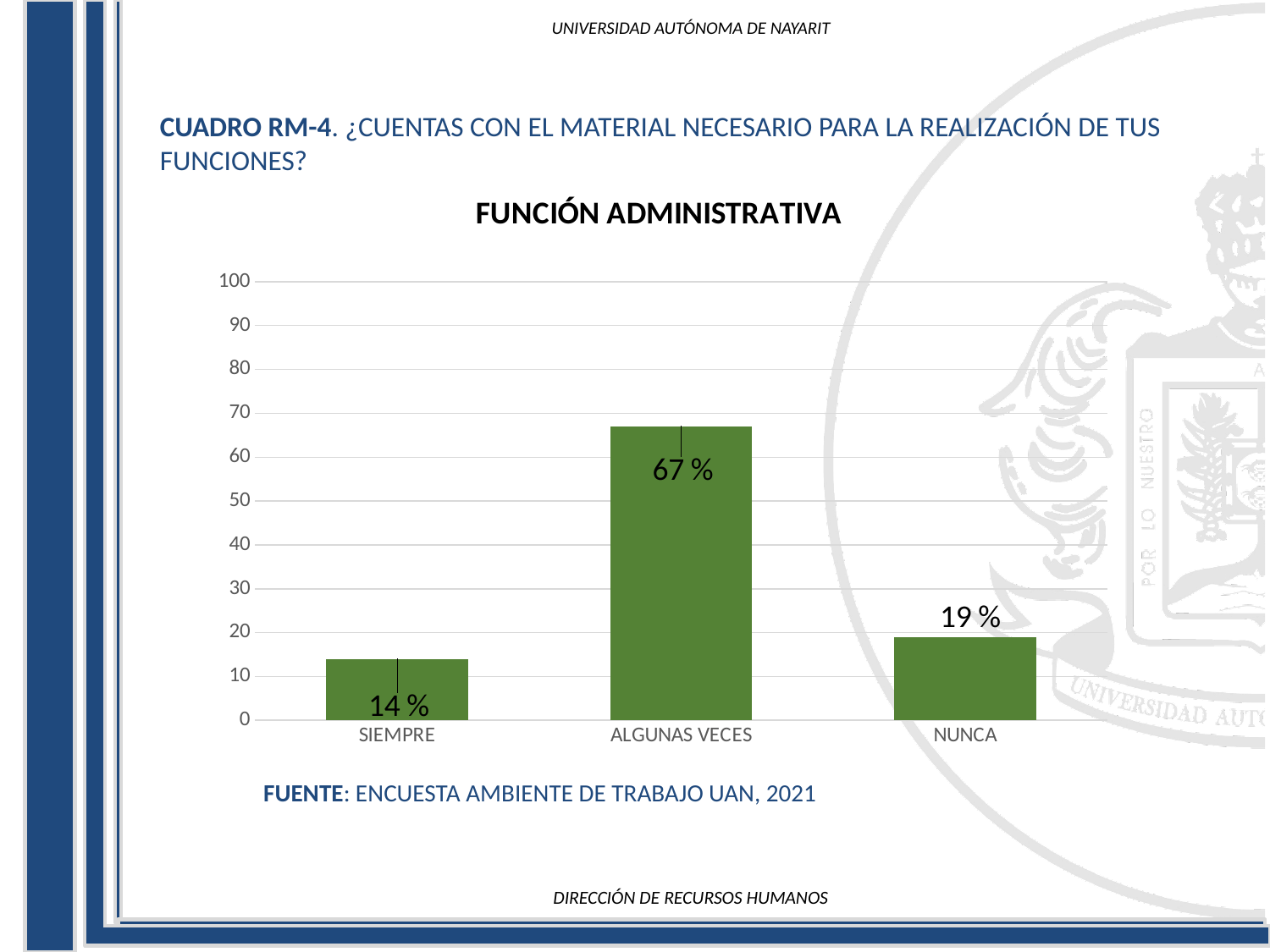
What is the value for NUNCA? 19 % Which is larger, the value for NUNCA or the value for SIEMPRE? NUNCA Which category has the highest value? ALGUNAS VECES What is the value for ALGUNAS VECES? 67 % What is the difference between the values for NUNCA and SIEMPRE? 5 % How many categories are shown on the x axis? 3 What is the value for SIEMPRE? 14 % What is the title of the chart? FUNCIÓN ADMINISTRATIVA What kind of chart is shown on the slide? bar chart What is the difference between the values for ALGUNAS VECES and NUNCA? 48 % Which category has the lowest value? SIEMPRE Is the value for ALGUNAS VECES greater or less than 60? greater